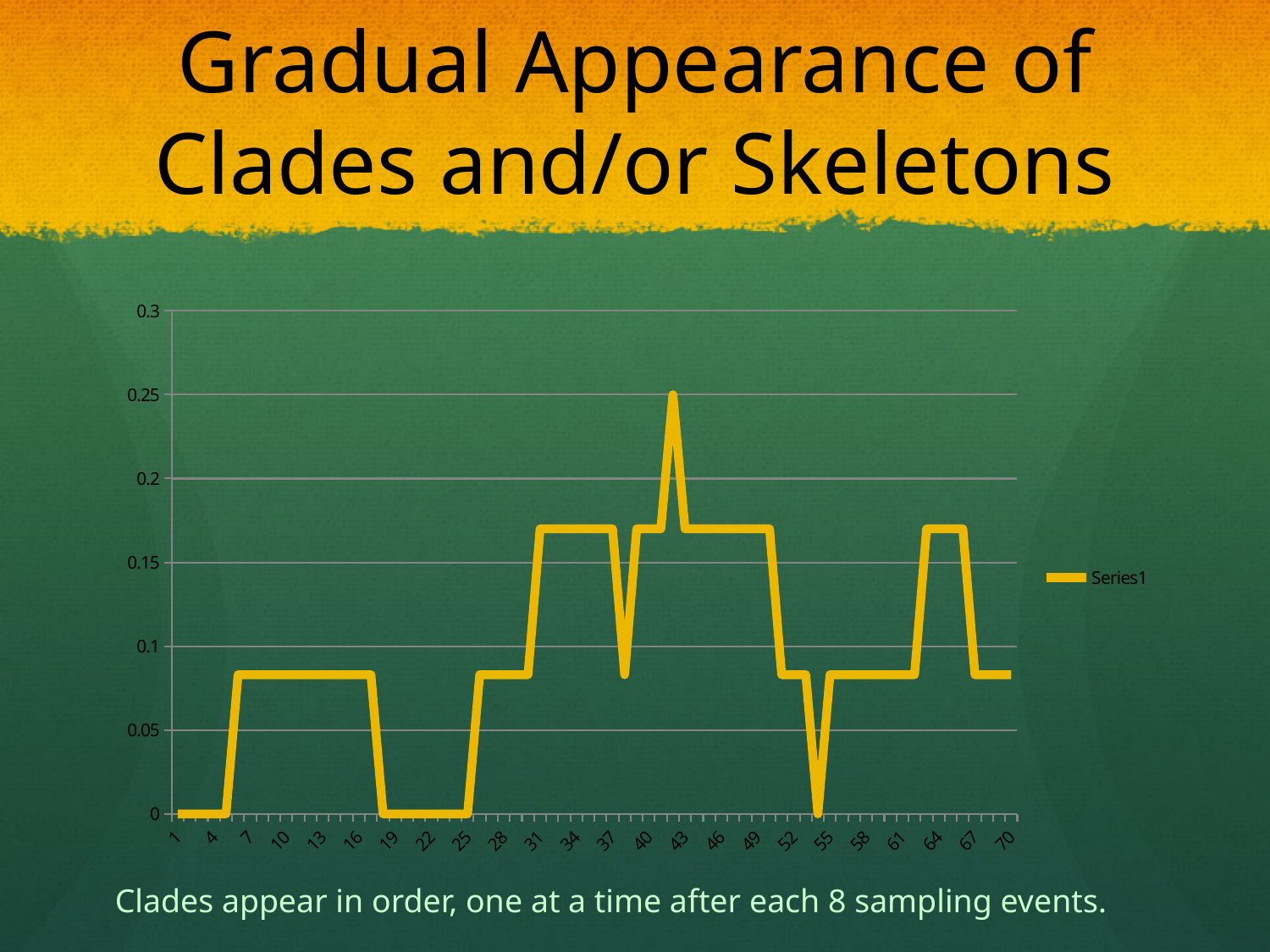
What kind of chart is shown on the slide? line chart What is the highest value shown on the vertical axis? 0.3 Is the value of Series1 at x = 31 greater or less than 0.15? greater Is the value of Series1 at x = 70 greater or less than 0.1? less Is the value of Series1 at x = 10 greater or less than 0.1? less Does the value of Series1 rise or fall between x = 64 and x = 70? fall How many series does the legend list? 1 What is the lowest value reached by Series1? 0 What is the value of Series1 at x = 22? 0 What is the name of the series shown in the legend? Series1 What is the value of Series1 at x = 1? 0